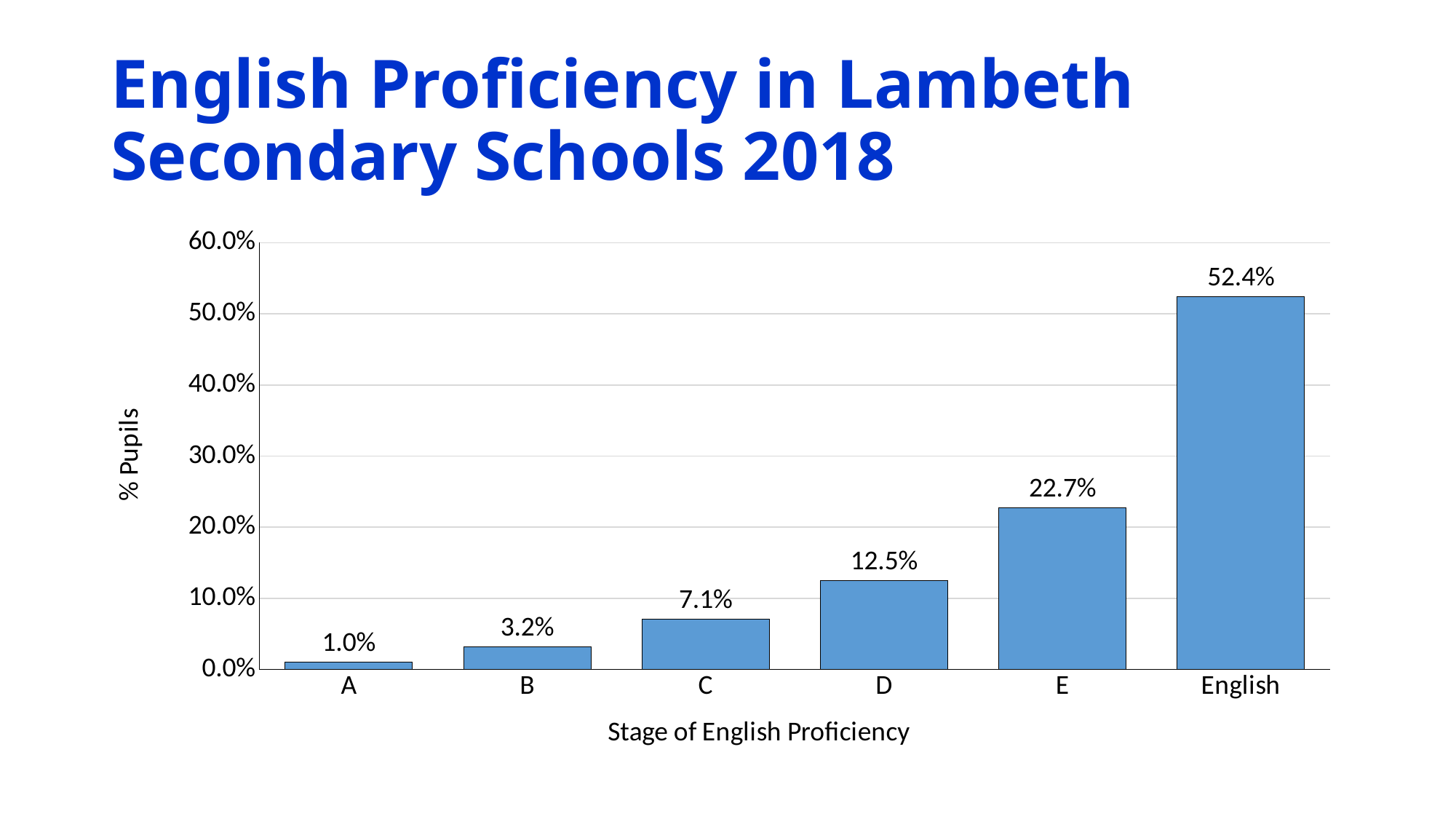
Which category has the highest percentage of pupils? English What kind of chart is shown on the slide? Bar chart Which has a larger percentage of pupils, stage B or stage C? C What is the difference in percentage points between stage E and stage D? 10.2% How many categories are shown on the x axis? 6 Which stage has the lowest percentage of pupils? A Do the values rise or fall moving from stage A to English along the x axis? Rise What percentage of pupils are at stage E? 22.7% Is the value for stage D greater or less than 10.0%? greater What is the value shown for the English category? 52.4% What percentage of pupils are at stage C of English proficiency? 7.1% What is the difference between the English category and stage E? 29.7%